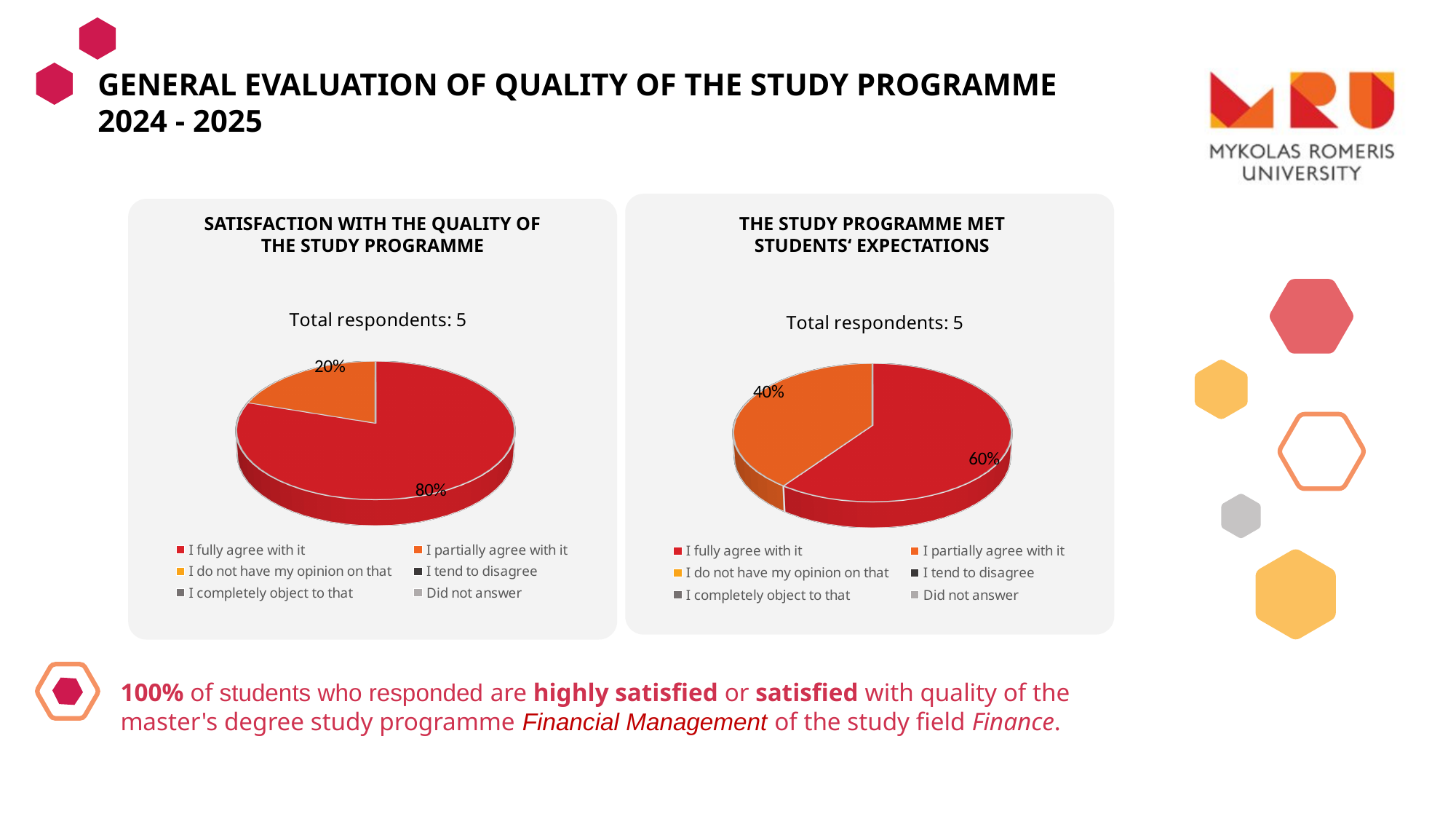
How many total respondents are reported for the 'Satisfaction with the quality of the study programme' chart? 5 In the 'The study programme met students' expectations' chart, what is the difference between the 'I fully agree with it' and 'I partially agree with it' shares? 20% What type of chart is used on the left side of the slide? Pie chart In the 'Satisfaction with the quality of the study programme' chart, what share of respondents chose 'I partially agree with it'? 20% In the 'The study programme met students' expectations' chart, which response has the smallest visible slice? I partially agree with it In the 'Satisfaction with the quality of the study programme' chart, what share of respondents chose 'I fully agree with it'? 80% In the 'The study programme met students' expectations' chart, what share of respondents chose 'I fully agree with it'? 60% In the 'Satisfaction with the quality of the study programme' chart, which response has the largest slice? I fully agree with it Which chart has the larger share for 'I fully agree with it': the left chart or the right chart? The left chart In the 'The study programme met students' expectations' chart, what share of respondents chose 'I partially agree with it'? 40% How many entries does the legend of the 'The study programme met students' expectations' chart list? 6 In the 'Satisfaction with the quality of the study programme' chart, what is the difference between the 'I fully agree with it' and 'I partially agree with it' shares? 60%